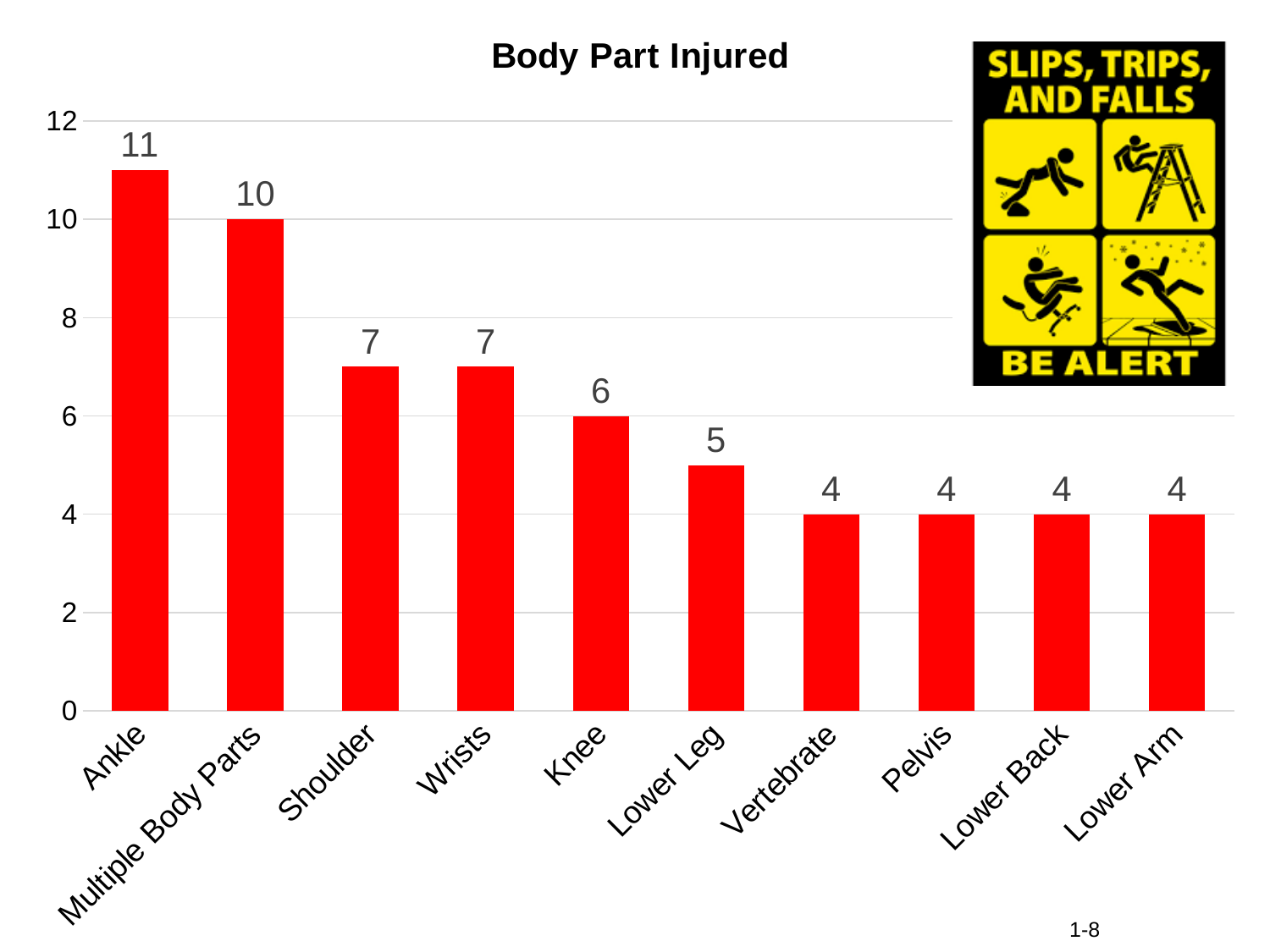
Is the value for Multiple Body Parts greater or less than 8? greater What is the value for Multiple Body Parts? 10 What kind of chart is this? bar chart Which body part has the highest value? Ankle What is the difference between the values for Multiple Body Parts and Pelvis? 6 Which is larger, the value for Knee or the value for Lower Leg? Knee What is the value for Lower Leg? 5 What is the difference between the values for Ankle and Shoulder? 4 How many body part categories are shown on the chart? 10 What is the title of the chart? Body Part Injured What is the value for Ankle? 11 What is the value for Knee? 6